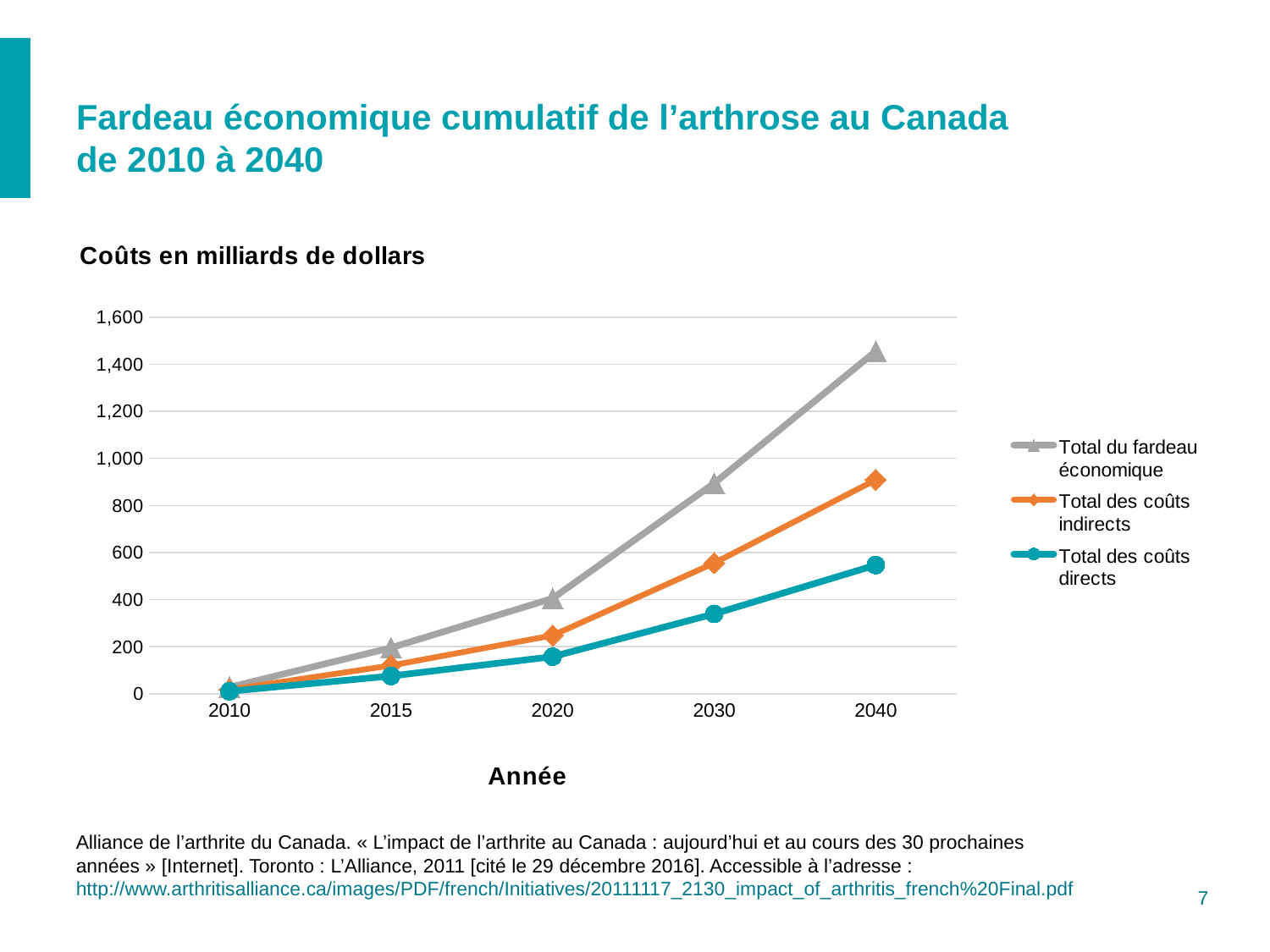
How many years are plotted along the x axis? 5 What is the label of the x axis? Année What kind of chart is shown on the slide? line chart Which series has the lowest value in 2040? Total des coûts directs Is the value for Total des coûts indirects in 2030 greater or less than 400? greater Is the value for Total des coûts directs in 2040 greater or less than 600? less Which series has the highest value in 2040? Total du fardeau économique How many series does the legend list? 3 Do the values for Total du fardeau économique rise or fall from 2010 to 2040? rise Is the value for Total du fardeau économique in 2040 greater or less than 1,400? greater In 2030, which is larger: Total des coûts indirects or Total des coûts directs? Total des coûts indirects What unit are the costs expressed in, according to the chart heading? milliards de dollars